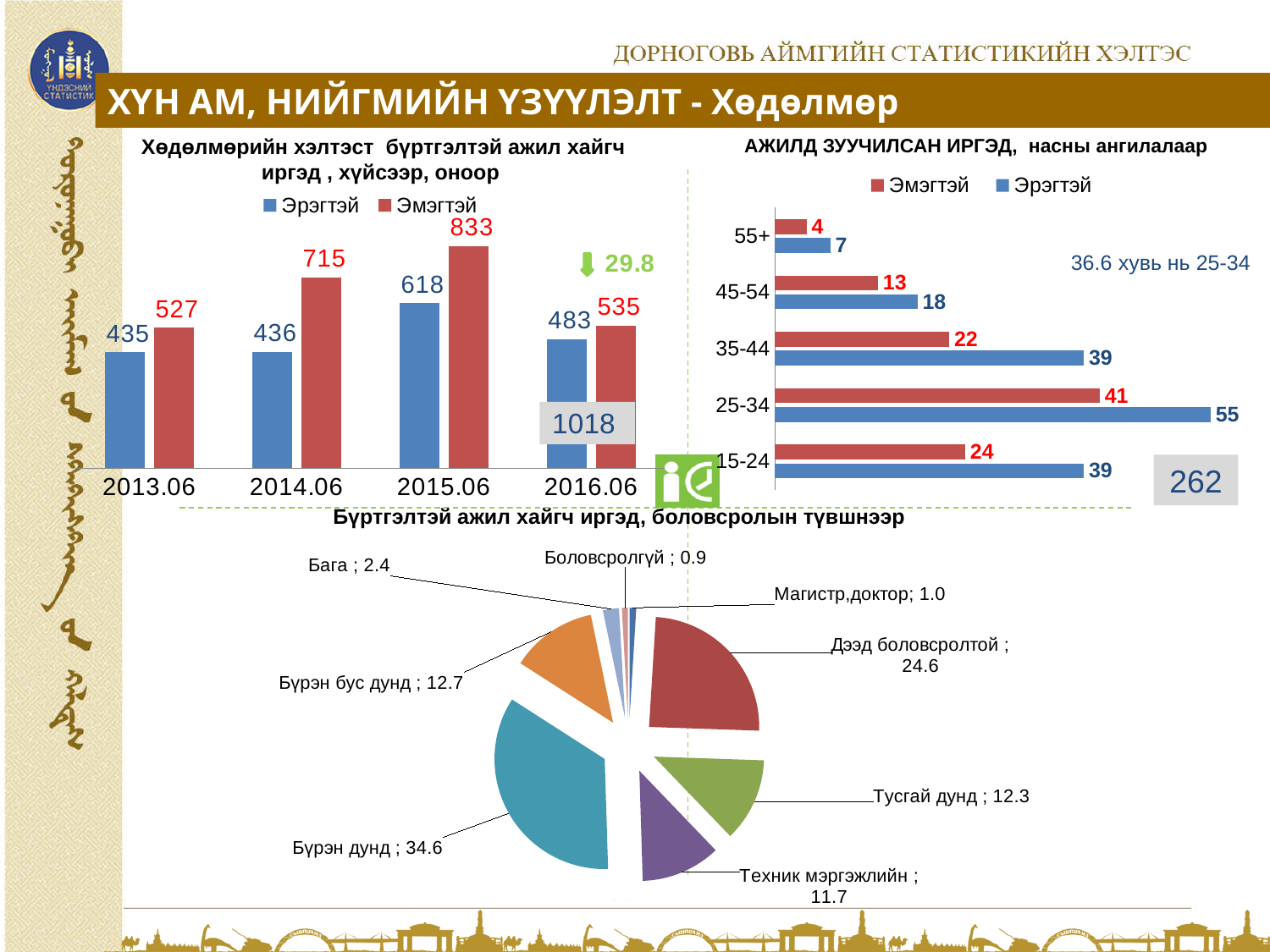
In the top-right chart of employed citizens by age group, how many age groups are shown? 5 In the top-left chart of registered job seekers by sex, what is the value for Эрэгтэй in 2014.06? 436 In the top-left chart of registered job seekers by sex, in which year is the Эмэгтэй value highest? 2015.06 In the bottom pie chart of registered job seekers by education level, what is the share for Бүрэн дунд? 34.6 In the top-left chart of registered job seekers by sex, what is the difference between the Эмэгтэй and Эрэгтэй values in 2016.06? 52 In the top-right chart of employed citizens by age group, which age group has the lowest Эмэгтэй value? 55+ In the top-left chart of registered job seekers by sex, what is the value for Эмэгтэй in 2015.06? 833 In the top-right chart of employed citizens by age group, what is the Эмэгтэй value for the 45-54 group? 13 In the top-right chart of employed citizens by age group, what is the Эрэгтэй value for the 25-34 group? 55 What type of chart is the bottom chart of registered job seekers by education level? pie chart In the top-right chart of employed citizens by age group, which is larger for the 15-24 group: Эрэгтэй or Эмэгтэй? Эрэгтэй In the top-left chart of registered job seekers by sex, how many series does the legend list? 2